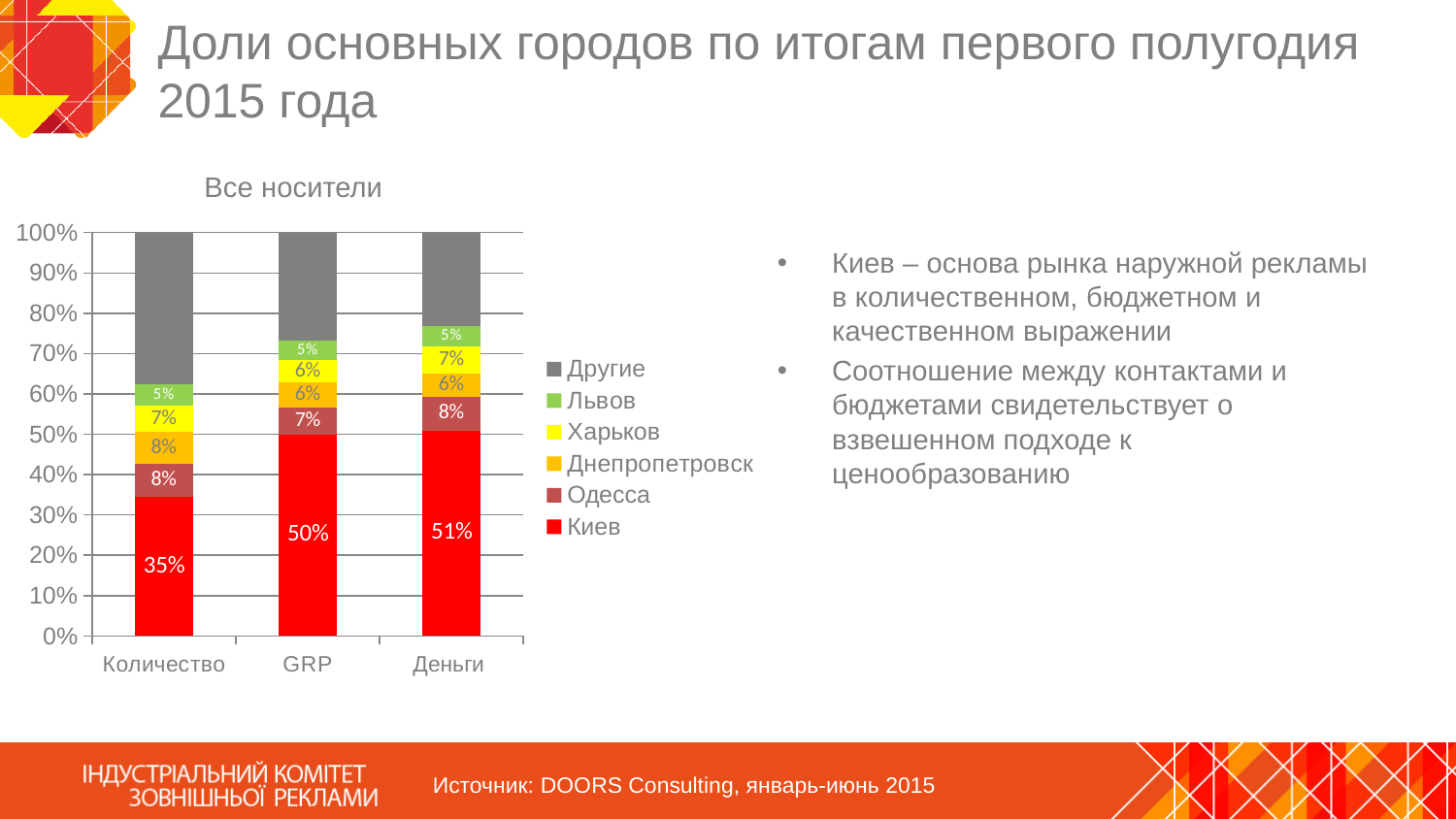
Which is larger: the Киев share in GRP or in Деньги? Деньги What is the value for Харьков in the Деньги bar? 7% What is the value for Одесса in the GRP bar? 7% How many categories are shown on the x axis? 3 What is the value for Киев in the Деньги bar? 51% What is the value for Киев in the Количество bar? 35% In which category does Киев have its lowest share? Количество In which category does Киев have its highest share? Деньги How many series does the legend list? 6 What kind of chart is shown on the slide? Stacked bar chart What is the difference between the Киев share in Деньги and in Количество? 16% Is the value for Другие in the Количество bar greater or less than 30%? greater